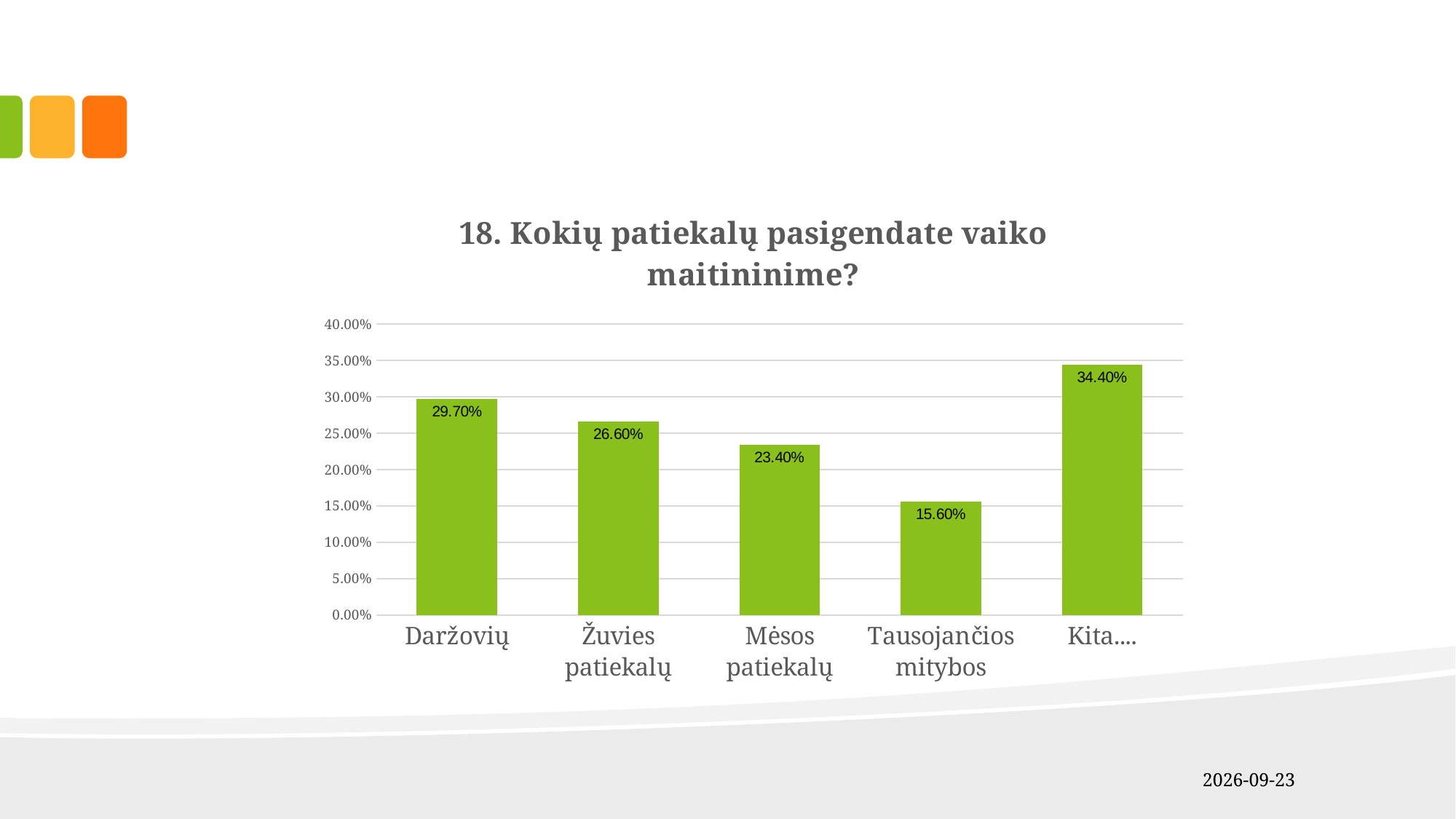
Which category has the highest value? Kita.... Which is larger, the value for Mėsos patiekalų or the value for Žuvies patiekalų? Žuvies patiekalų What is the value for Daržovių? 29.70% What is the difference between the values for Daržovių and Žuvies patiekalų? 3.10% What is the value for Tausojančios mitybos? 15.60% What is the difference between the values for Kita.... and Tausojančios mitybos? 18.80% Is the value for Kita.... greater or less than 30.00%? greater Which category has the lowest value? Tausojančios mitybos What is the value for Žuvies patiekalų? 26.60% How many categories are shown on the x axis? 5 What is the value for Mėsos patiekalų? 23.40% What kind of chart is shown on the slide? bar chart